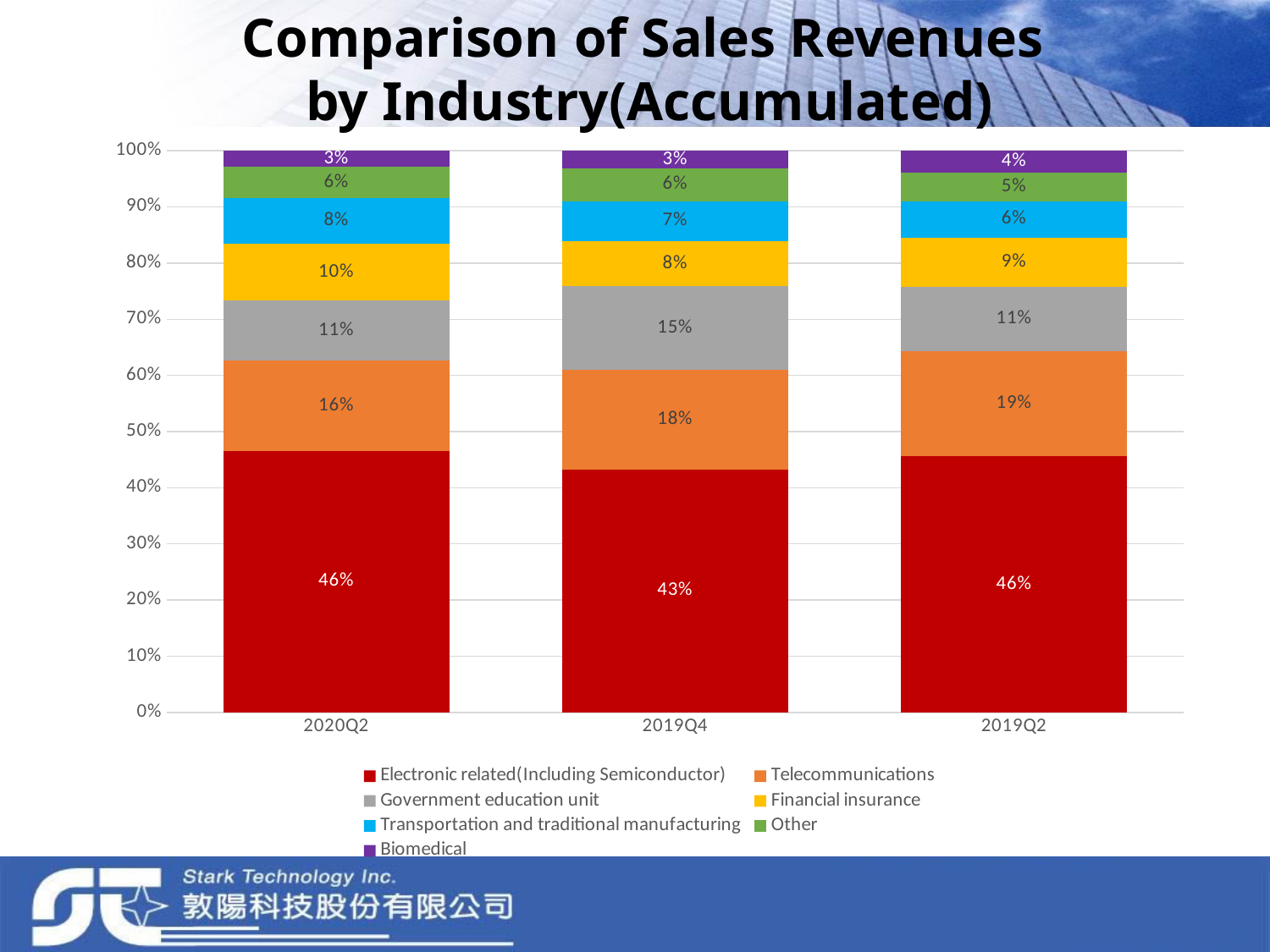
What is the value for Government education unit in 2019Q4? 15% Which is larger: the Transportation and traditional manufacturing share in 2020Q2 or in 2019Q2? 2020Q2 What is the difference between the Electronic related(Including Semiconductor) share in 2020Q2 and in 2019Q4? 3% In which period is the Telecommunications share the lowest? 2020Q2 What is the value for Biomedical in 2019Q2? 4% How many series does the legend list? 7 What is the value for Telecommunications in 2019Q2? 19% In which period is the Government education unit share the highest? 2019Q4 What is the value for Electronic related(Including Semiconductor) in 2019Q4? 43% What is the value for Financial insurance in 2020Q2? 10% What kind of chart is shown on the slide? Stacked bar chart How many periods are shown on the x axis? 3